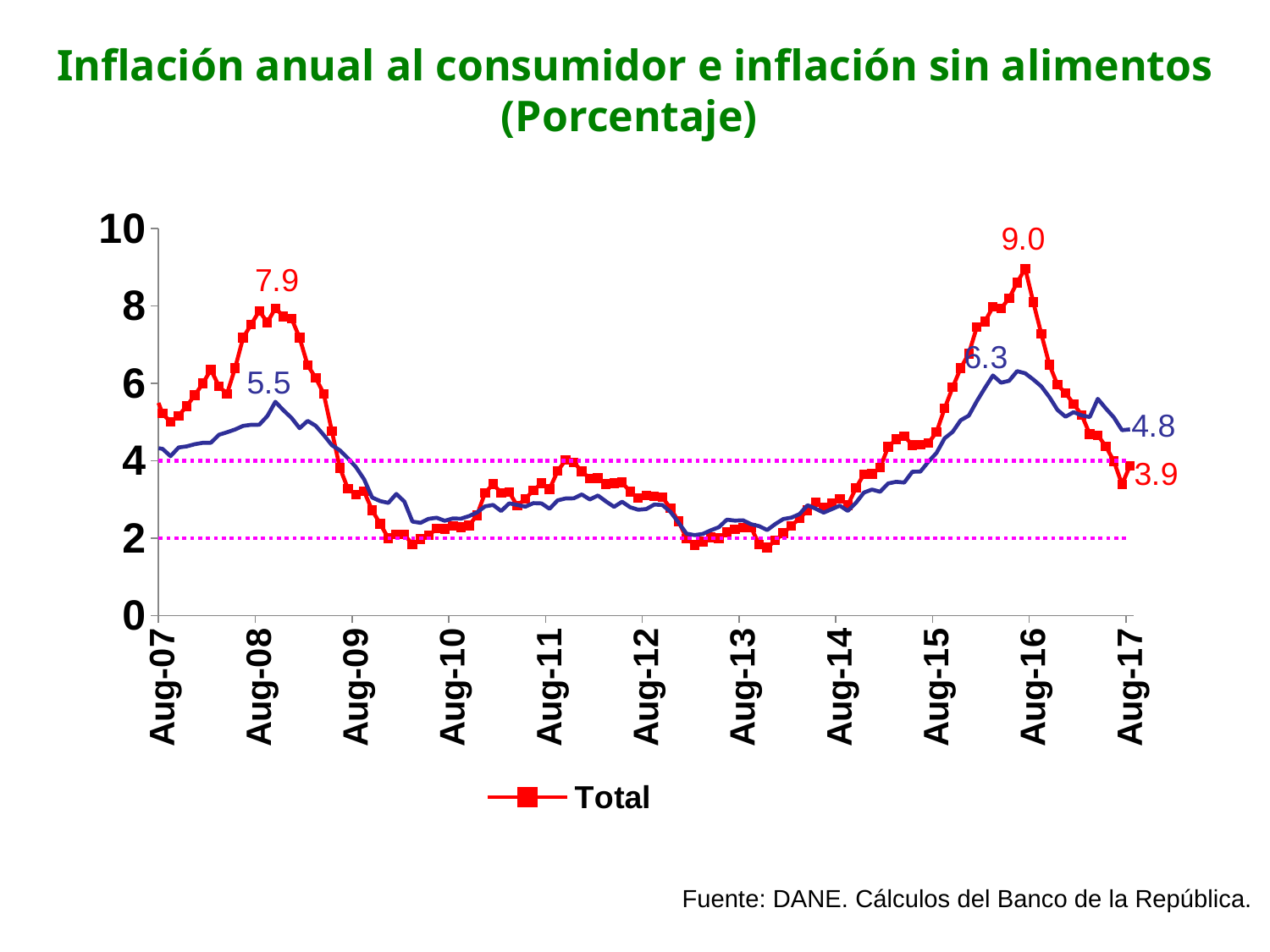
What is the highest value labeled anywhere on the chart? 9.0 Is the value of the Total series at Aug-13 greater or less than 4? less What kind of chart is shown on the slide? line chart What is the last labeled value of the Total series at Aug-17? 3.9 What is the difference between the Total peak near Aug-16 (9.0) and the Total peak near Aug-08 (7.9)? 1.1 At Aug-17, what is the difference between the blue line value (4.8) and the Total value (3.9)? 0.9 What is the peak value labeled on the Total series near Aug-16? 9.0 What is the difference between the blue line's labeled peaks of 6.3 and 5.5? 0.8 What is the value labeled on the Total series at its peak near Aug-08? 7.9 How many series does the legend list? 1 At Aug-17, which is higher: the Total series or the blue line? the blue line What is the last labeled value of the blue line at Aug-17? 4.8